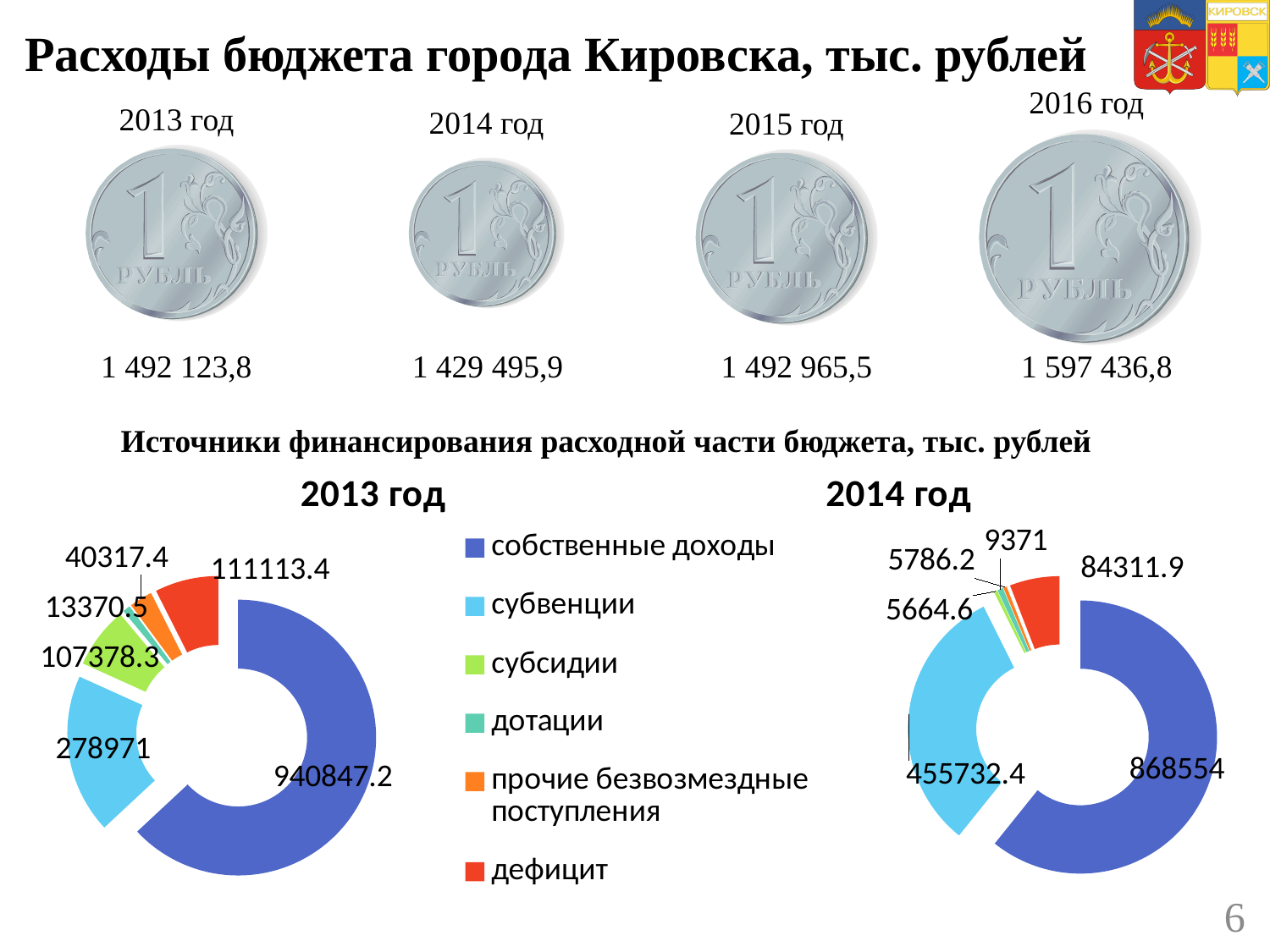
How many categories does the legend list for the charts? 6 On the 2013 год chart, which category has the largest value? собственные доходы On the 2014 год chart, what is the value for собственные доходы? 868554 On the 2013 год chart, what is the value for собственные доходы? 940847.2 On the 2013 год chart, what is the value for субвенции? 278971 On the 2013 год chart, what is the value for дефицит? 111113.4 What type of chart is used for 2013 год and 2014 год? doughnut chart On the 2013 год chart, which category has the smallest value? дотации What is the difference between собственные доходы on the 2013 год chart and on the 2014 год chart? 72293.2 On the 2014 год chart, what is the value for дефицит? 84311.9 On the 2014 год chart, which is larger: собственные доходы or субвенции? собственные доходы On the 2014 год chart, what is the value for субвенции? 455732.4